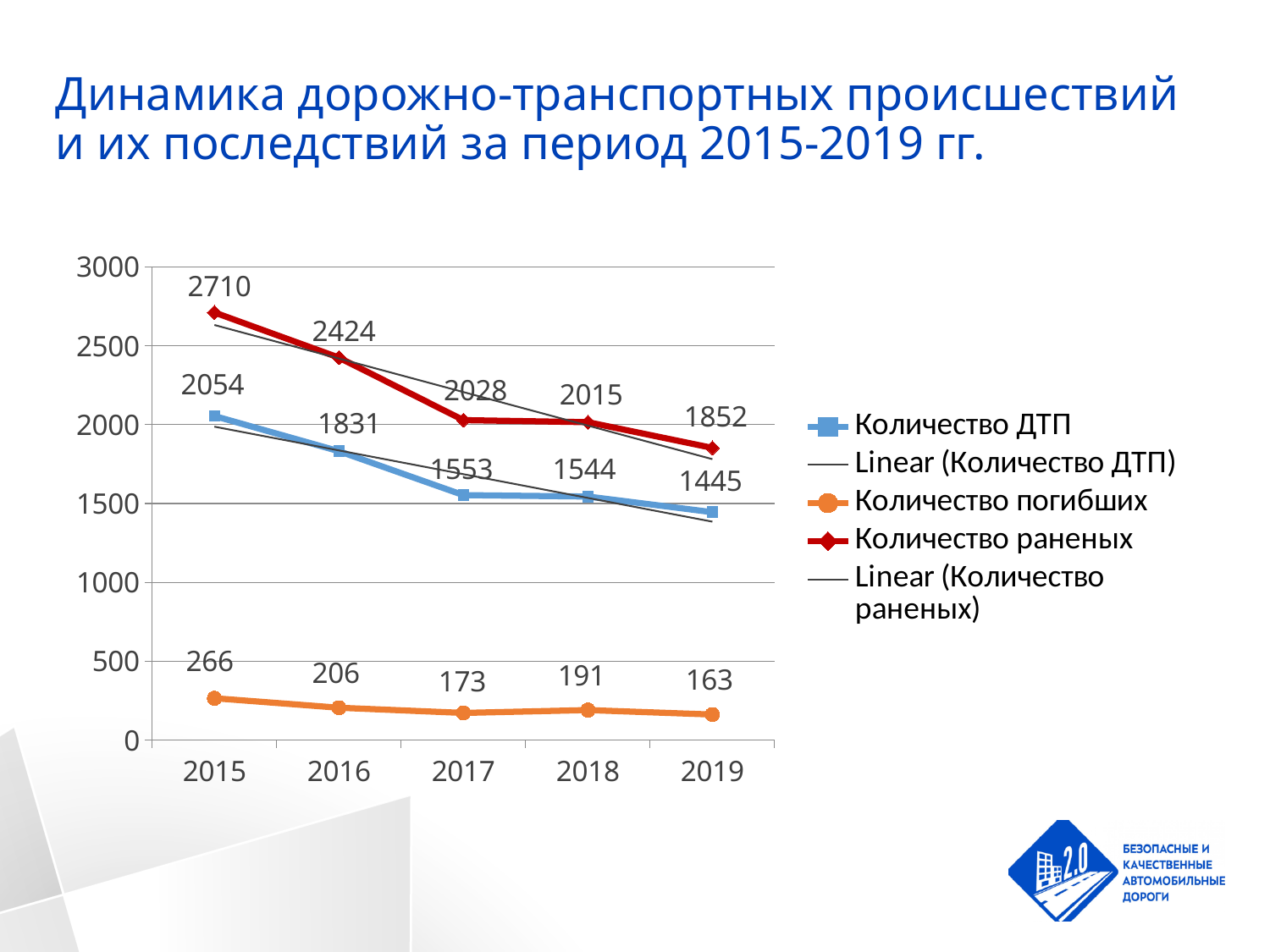
In which year is Количество погибших the highest? 2015 Which is larger: Количество раненых in 2017 or in 2018? 2017 Does Количество раненых rise or fall from 2015 to 2019? fall Is the value of Количество ДТП in 2016 greater or less than 2000? less What is the value of Количество погибших in 2018? 191 In which year is Количество раненых the lowest? 2019 What is the value of Количество ДТП in 2017? 1553 What kind of chart is shown on the slide? line chart What is the value of Количество раненых in 2015? 2710 What is the difference between Количество ДТП in 2015 and in 2019? 609 How many entries does the legend list? 5 How many years are shown on the x axis? 5